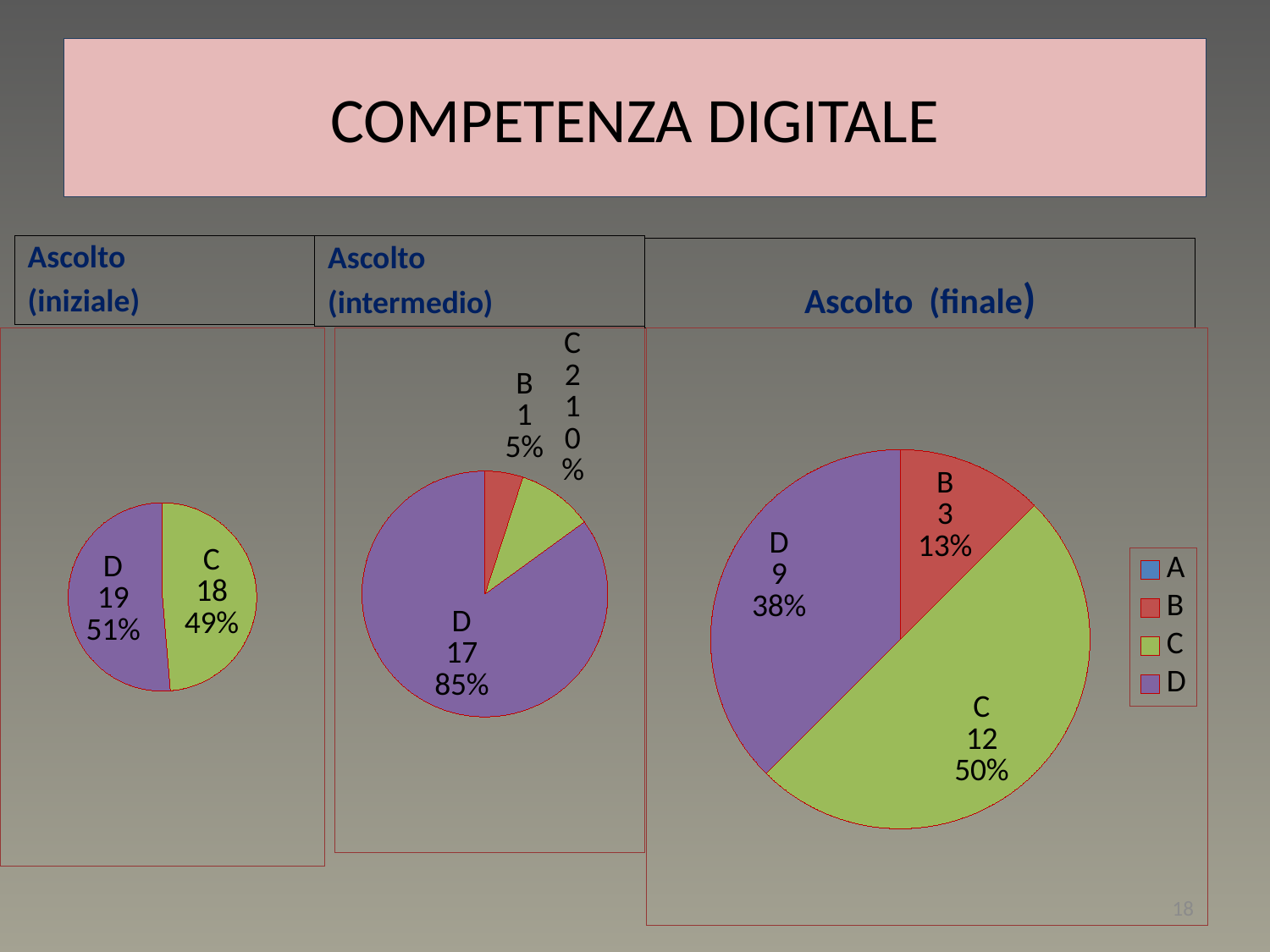
In the Ascolto (intermedio) chart, which category has the smallest slice? B In the Ascolto (finale) chart, what is the difference between the values for C and D? 3 In the Ascolto (finale) chart, what share of the pie does category D have? 38% In the Ascolto (iniziale) chart, what share of the pie does category C have? 49% In the Ascolto (finale) chart, what value is shown for category C? 12 In the Ascolto (intermedio) chart, what value is shown for category D? 17 In the Ascolto (intermedio) chart, what share of the pie does category B have? 5% In the Ascolto (finale) chart, which category has the largest slice? C How many entries does the legend of the Ascolto (finale) chart list? 4 What kind of chart is the Ascolto (iniziale) chart? Pie chart In the Ascolto (iniziale) chart, what value is shown for category D? 19 In the Ascolto (finale) chart, which is larger, the value for B or the value for D? D